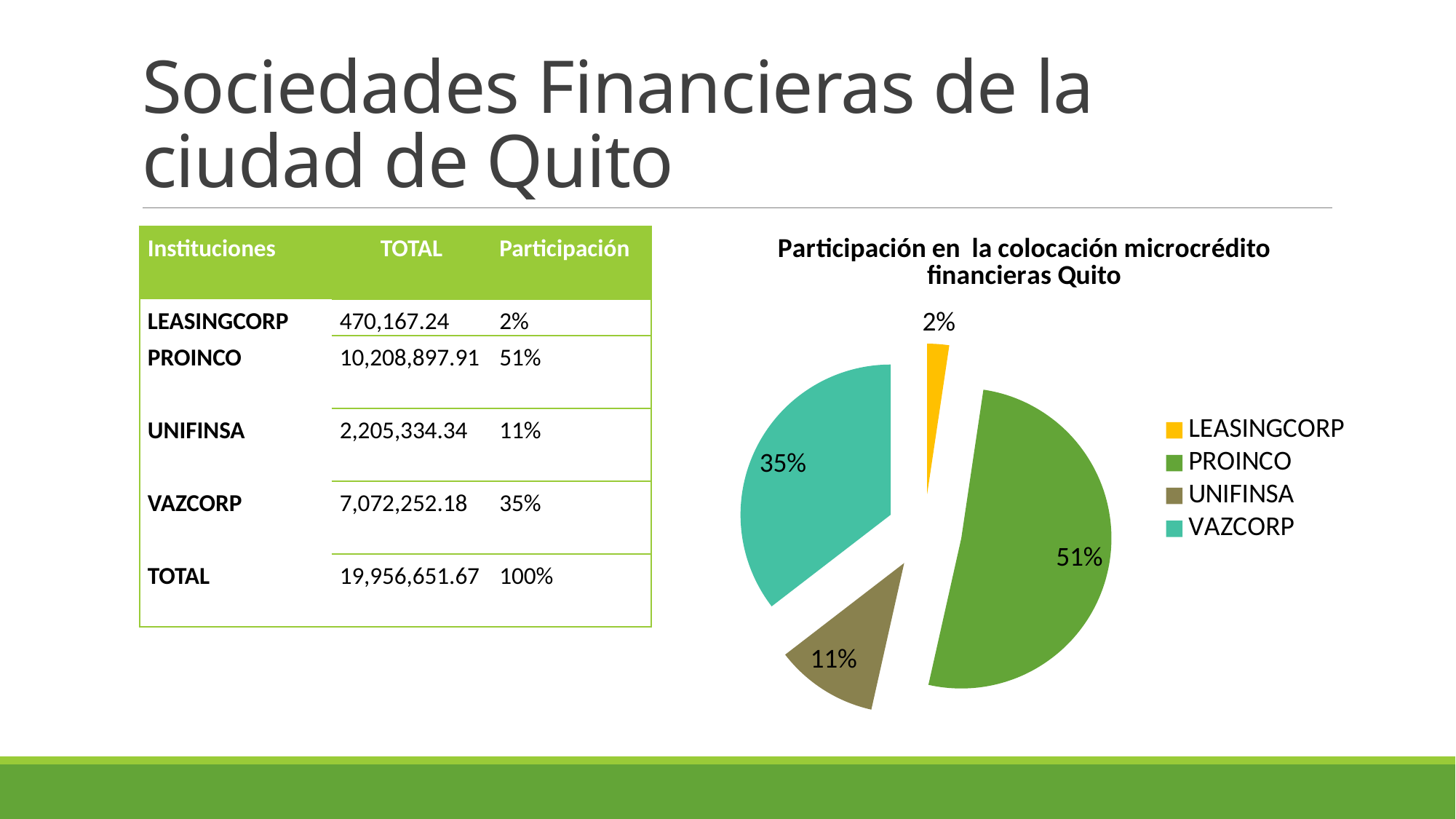
What kind of chart is shown on the slide? Pie chart What share of the pie does UNIFINSA hold? 11% How many entries does the legend of the pie chart list? 4 Which slice is larger, UNIFINSA or VAZCORP? VAZCORP What share of the pie does LEASINGCORP hold? 2% How many slices does the pie chart have? 4 Which institution has the smallest slice of the pie? LEASINGCORP What share of the pie does PROINCO hold? 51% Which institution has the largest slice of the pie? PROINCO What is the title of the pie chart? Participación en la colocación microcrédito financieras Quito What is the difference in percentage points between the PROINCO slice and the VAZCORP slice? 16%